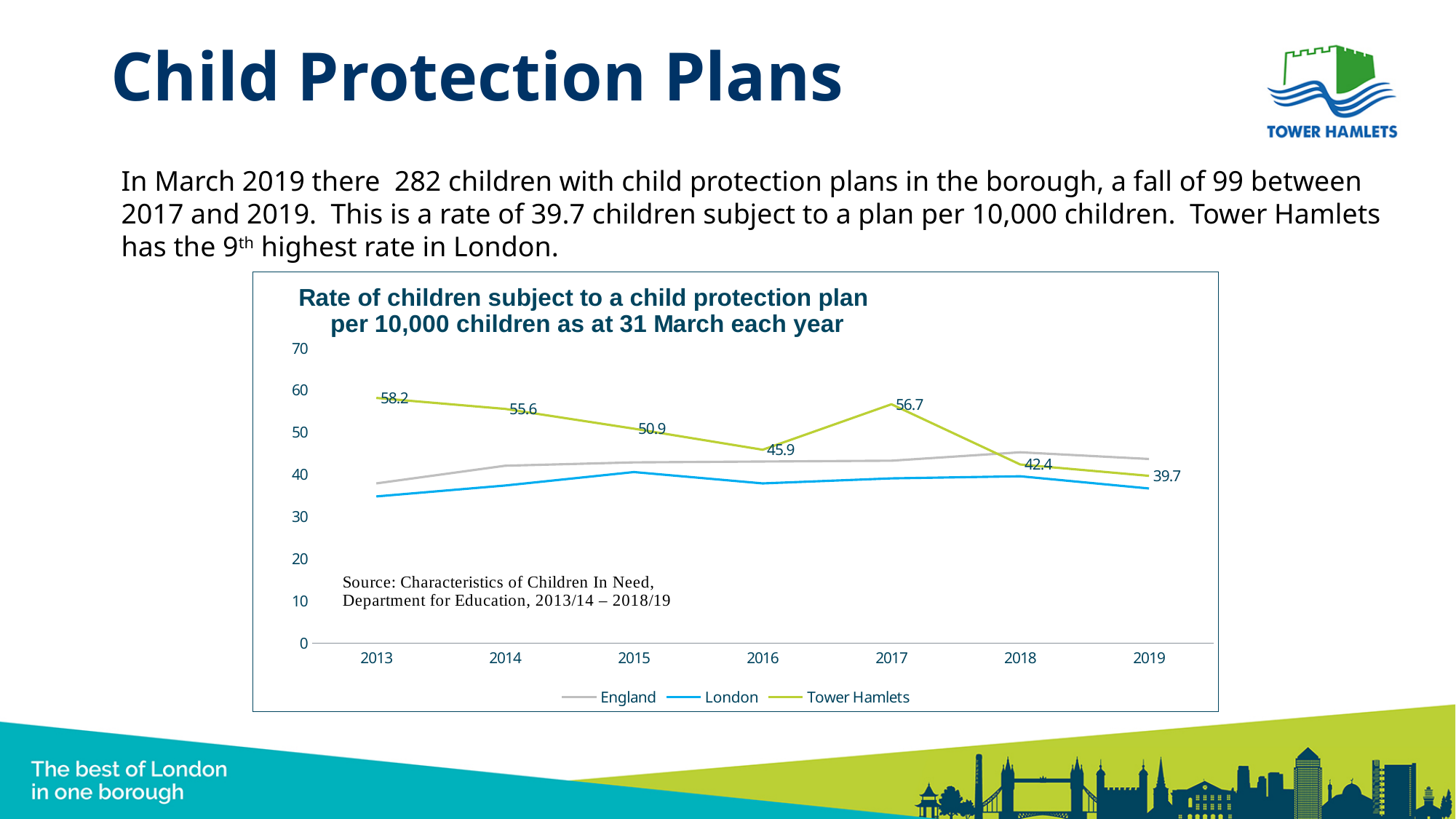
What is the Tower Hamlets value in 2019? 39.7 What is the Tower Hamlets value in 2017? 56.7 In which year is the Tower Hamlets rate lowest? 2019 What kind of chart is shown on the slide? line chart How many series does the legend list? 3 In which year is the Tower Hamlets rate highest? 2013 Is the London value in 2019 greater or less than 40? less What is the Tower Hamlets rate of children subject to a child protection plan in 2013? 58.2 Is the England value in 2013 greater or less than 40? less What is the difference between the Tower Hamlets values in 2013 and 2019? 18.5 Which is larger for Tower Hamlets: the 2016 value or the 2017 value? 2017 How many years are shown on the x axis? 7